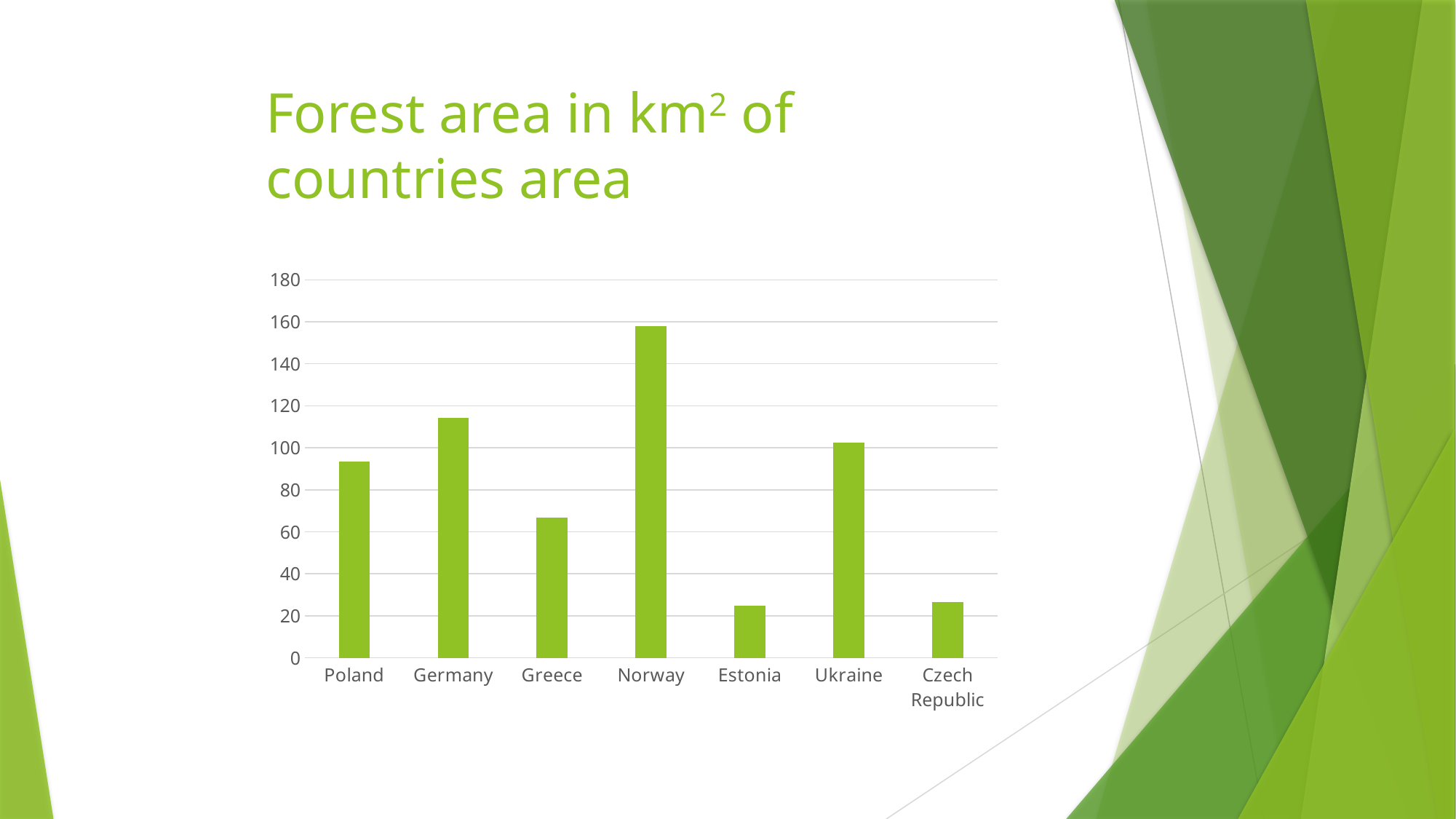
How many countries are shown on the x axis of the chart? 7 Which country has the highest bar in the chart? Norway Is the value for Estonia greater or less than 40? less Is the value for Germany greater or less than 100? greater What is the title of the slide containing the chart? Forest area in km² of countries area What type of chart is shown on the slide? bar chart Is the value for Ukraine greater or less than 120? less Which has a larger value, Germany or Ukraine? Germany Which has a larger value, Greece or Czech Republic? Greece